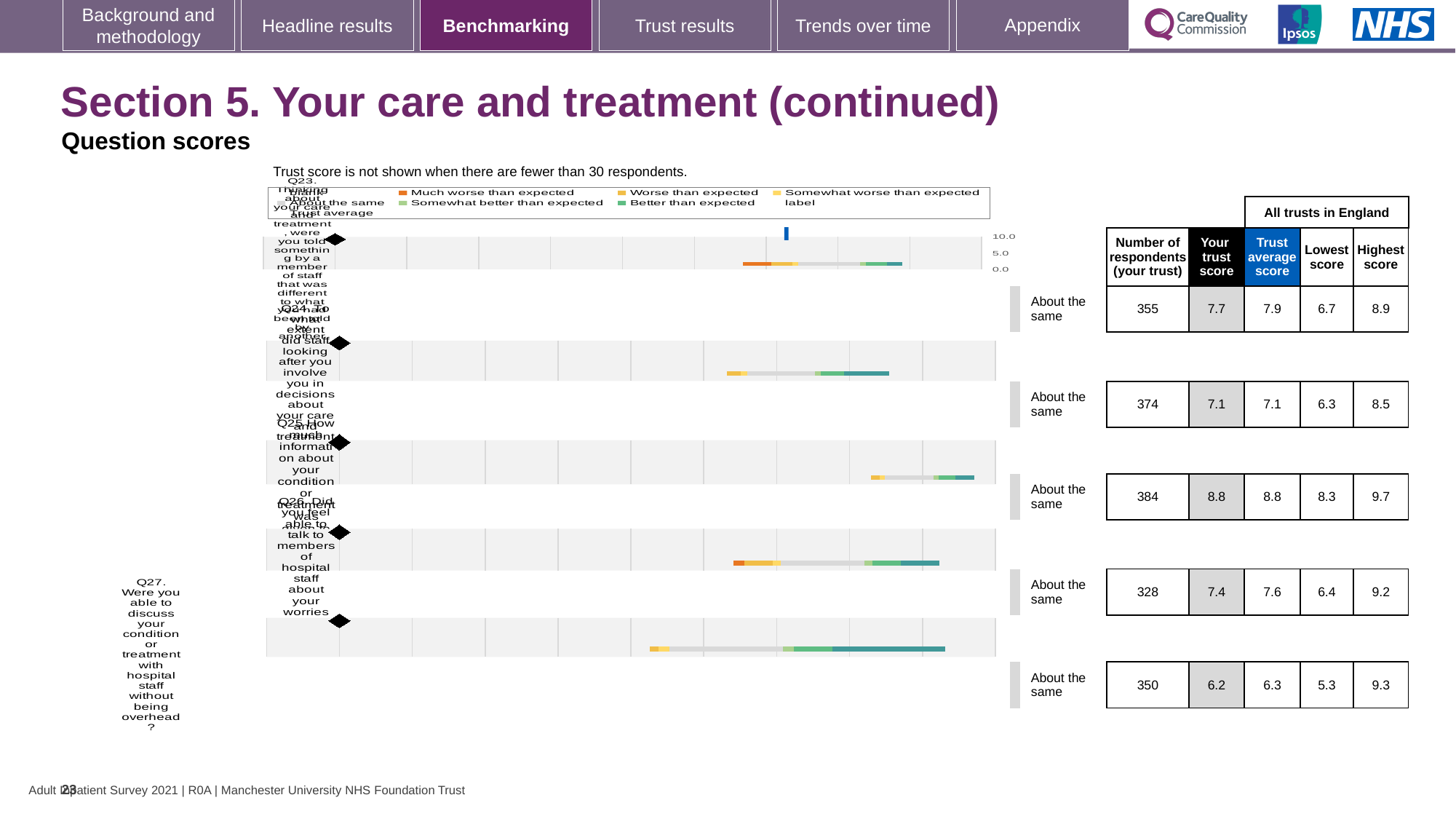
What is the trust average score for Q24 (staff involving you in decisions about your care and treatment)? 7.1 What kind of chart is used to show the question scores on this slide? bar chart Which question has the highest trust score? Q25 Which question has the lowest trust score? Q27 What is the trust score for Q23 (told something different by another member of staff)? 7.7 What is the difference between the trust average score and the trust score for Q26? 0.2 Is the trust score for Q23 larger or smaller than the trust score for Q24? larger What benchmark category is shown for every question on this slide? About the same How many respondents answered Q25 (information about your condition or treatment)? 384 How many questions (Q23 to Q27) are plotted in the benchmarking chart? 5 What is the highest score across all trusts in England for Q27 (discussing your condition without being overheard)? 9.3 What is the lowest score across all trusts in England for Q26 (talking to hospital staff about your worries)? 6.4